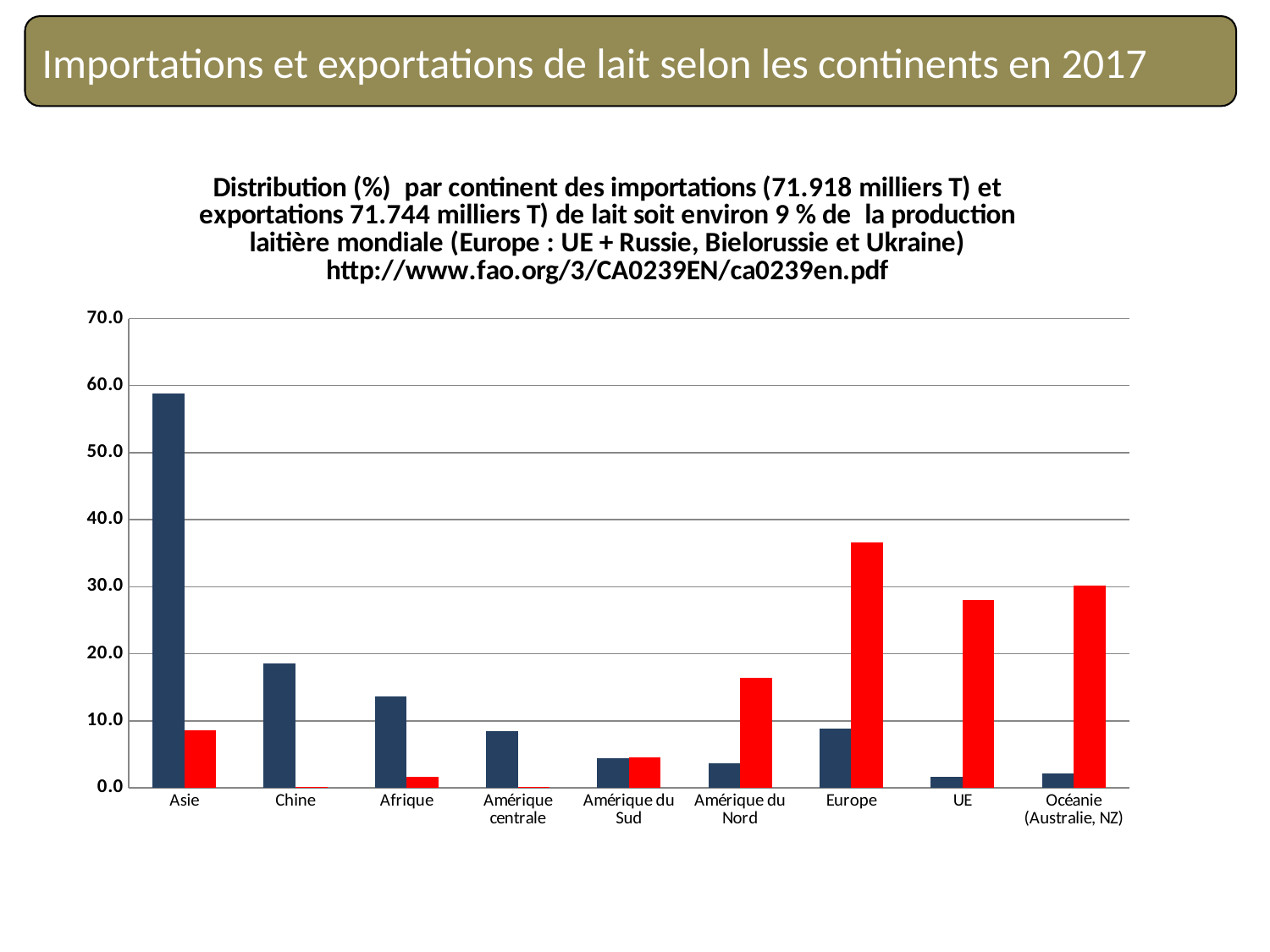
What kind of chart is shown on the slide? bar chart Which category has the tallest red bar? Europe How many categories are shown along the x axis of the chart? 9 Is the dark blue bar for Asie greater or less than 50.0? greater Is the red bar for Océanie (Australie, NZ) greater or less than 20.0? greater Which category has the tallest dark blue bar? Asie Is the red bar for Amérique du Nord greater or less than 10.0? greater For Asie, which bar is taller, the dark blue one or the red one? the dark blue one For UE, which bar is taller, the dark blue one or the red one? the red one What is the highest value shown on the y axis of the chart? 70.0